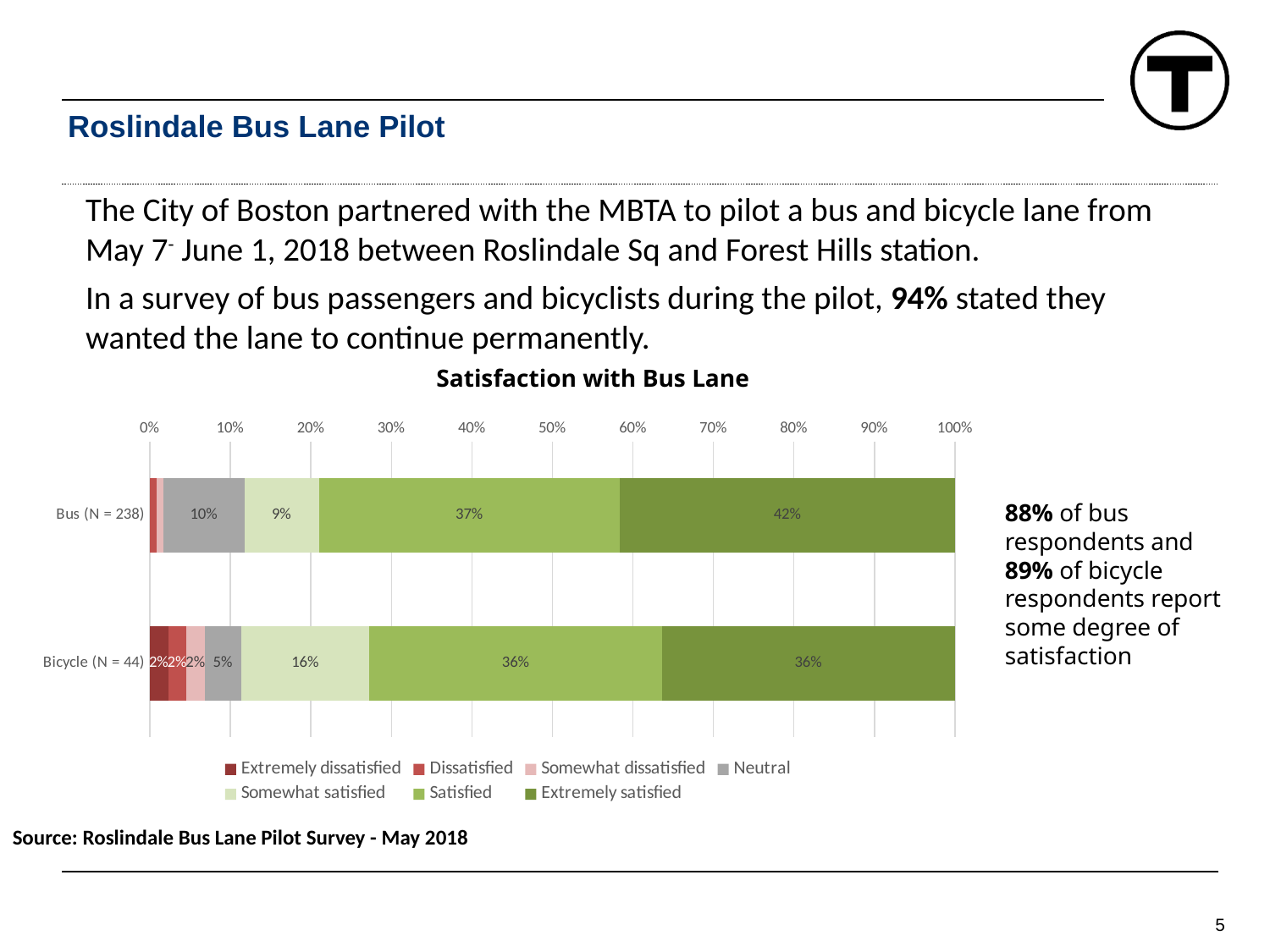
What percentage of bicycle respondents were Neutral? 5% What percentage of bicycle respondents were Somewhat satisfied? 16% What percentage of bus respondents were Neutral? 10% What is the difference in percentage points between the Extremely satisfied share for Bus (42%) and for Bicycle (36%)? 6 percentage points What is the difference in percentage points between the Neutral share for Bus (10%) and for Bicycle (5%)? 5 percentage points How many respondent groups (bars) are shown in the "Satisfaction with Bus Lane" chart? 2 What is the sample size (N) for the Bus group in the chart? 238 What kind of chart is shown under the title "Satisfaction with Bus Lane"? Stacked bar chart How many series does the legend of the "Satisfaction with Bus Lane" chart list? 7 Which satisfaction level has the largest share among bus respondents? Extremely satisfied What percentage of bus respondents were Extremely satisfied? 42% Which group has a larger Extremely satisfied share, Bus or Bicycle? Bus